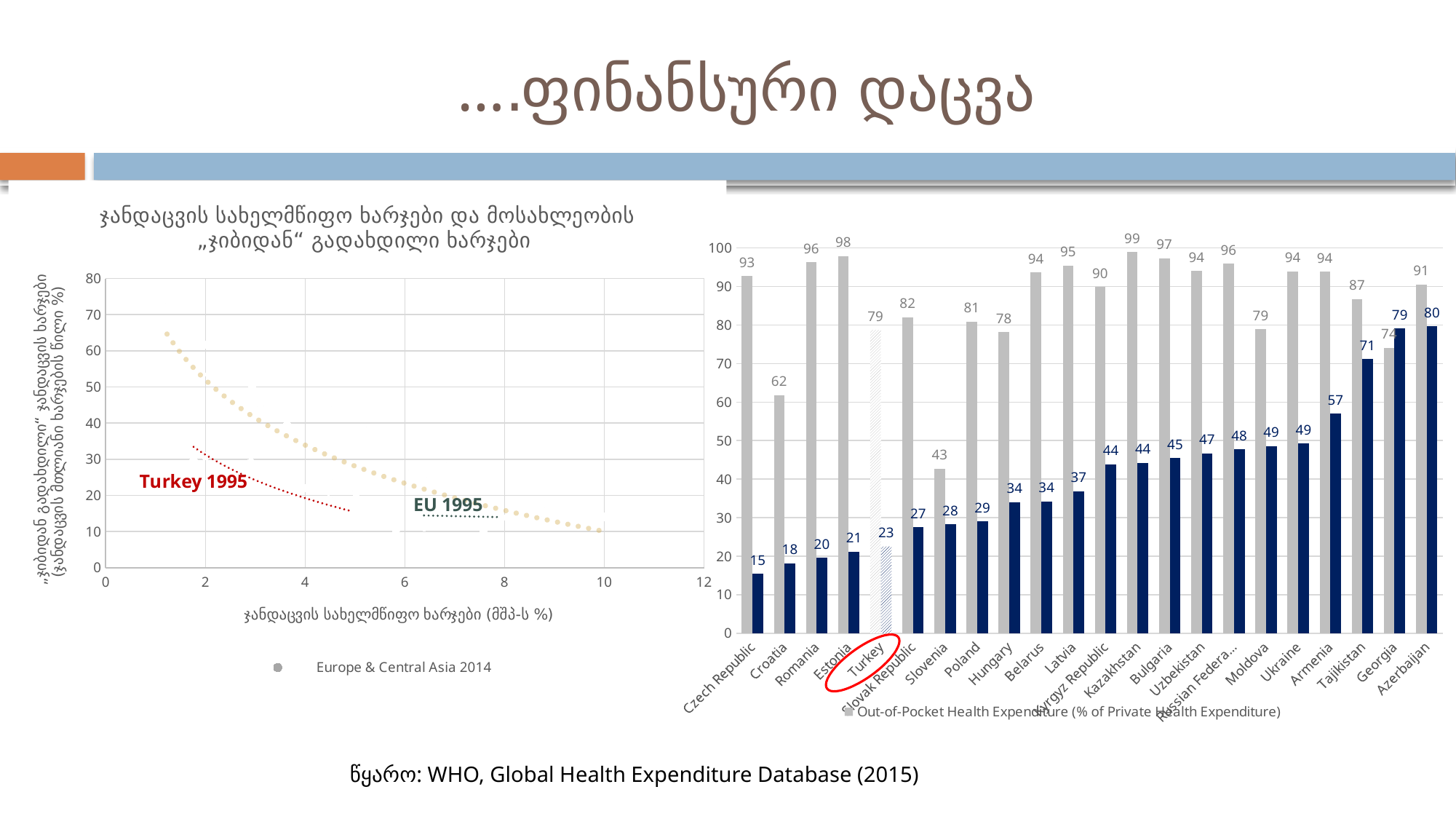
On the right-hand bar chart, what is the grey bar value for Turkey? 79 On the right-hand bar chart, how many countries are shown on the x axis? 22 On the left-hand scatter chart, what is the legend entry for the dotted series? Europe & Central Asia 2014 On the right-hand bar chart, which country has the highest grey bar value? Kazakhstan What kind of chart is the chart on the right of the slide? bar chart On the right-hand bar chart, which country has the lowest grey bar value? Slovenia On the right-hand bar chart, what is the dark blue bar value for Georgia? 79 What kind of chart is the chart on the left of the slide? scatter chart On the right-hand bar chart, do the dark blue bar values rise or fall from left to right? rise On the right-hand bar chart, which is larger: the dark blue bar for Armenia or the dark blue bar for Tajikistan? Tajikistan On the right-hand bar chart, which country has the lowest dark blue bar value? Czech Republic On the right-hand bar chart, what is the difference between the grey bar and the dark blue bar for Croatia? 44